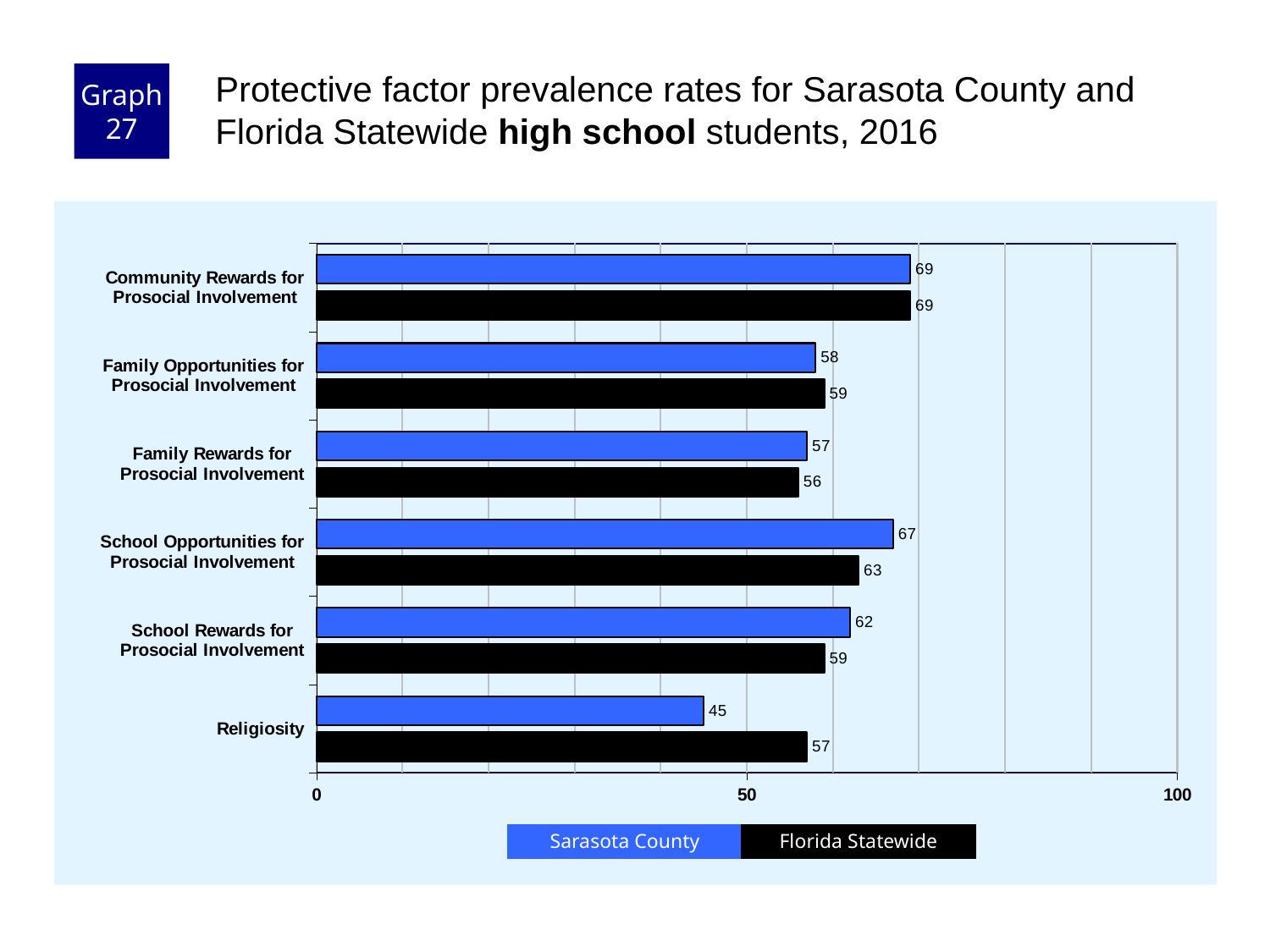
What is the Florida Statewide value for Religiosity? 57 What is the difference between the Sarasota County and Florida Statewide values for School Opportunities for Prosocial Involvement? 4 Which category has the lowest Sarasota County value? Religiosity Which is larger for School Rewards for Prosocial Involvement, the Sarasota County value or the Florida Statewide value? Sarasota County What kind of chart is shown on the slide? bar chart Which category has the highest Florida Statewide value? Community Rewards for Prosocial Involvement Is the Sarasota County value for Religiosity greater or less than 50? less What is the difference between the Florida Statewide and Sarasota County values for Religiosity? 12 How many series does the legend list? 2 How many categories are shown on the chart? 6 What is the Sarasota County value for School Opportunities for Prosocial Involvement? 67 What is the Sarasota County value for Community Rewards for Prosocial Involvement? 69